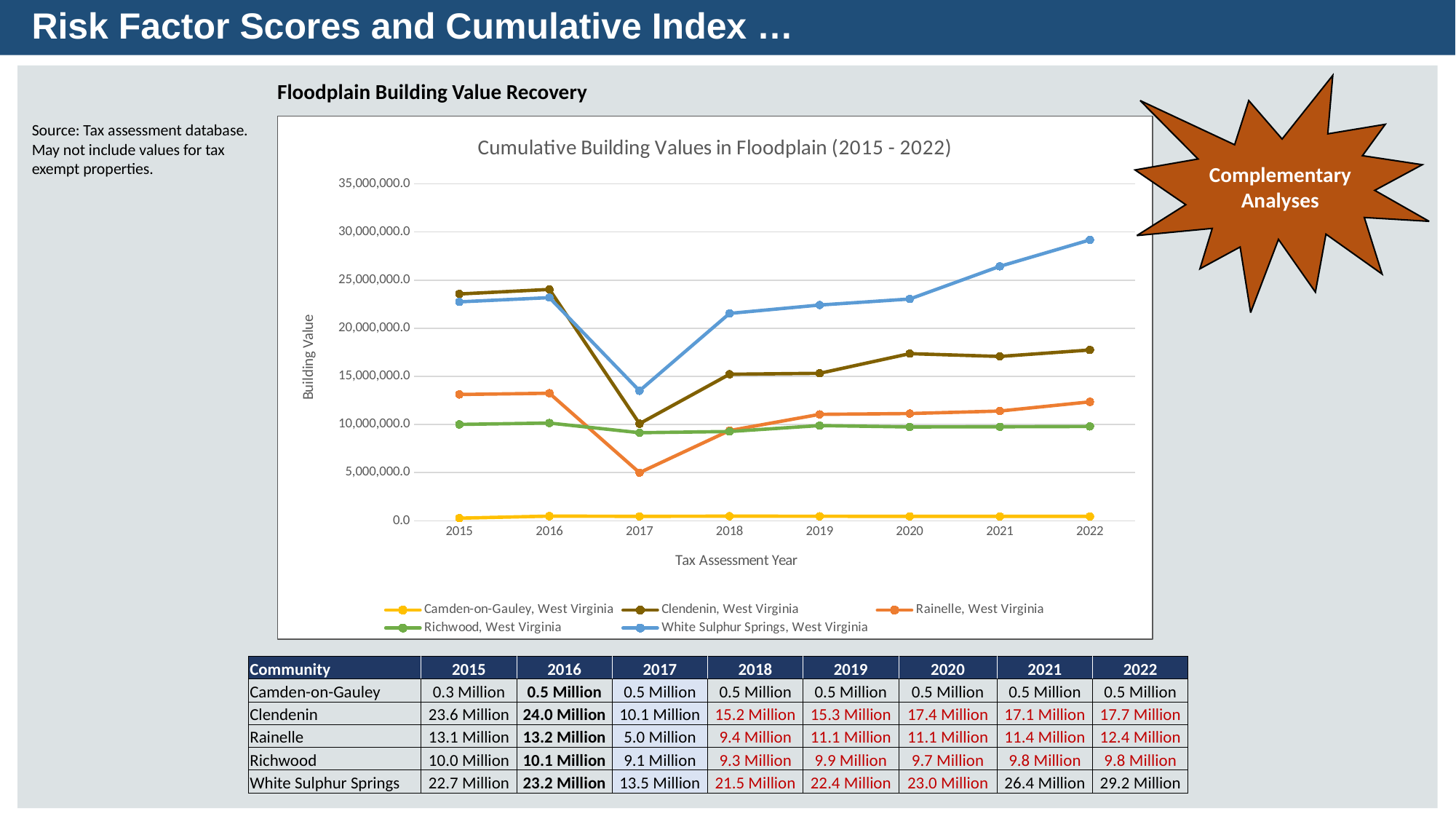
Which community has the highest building value in 2022? White Sulphur Springs What is the title of the chart? Cumulative Building Values in Floodplain (2015 - 2022) Which is larger in 2015, the building value for Clendenin or for White Sulphur Springs? Clendenin Which community has the lowest building value in 2015? Camden-on-Gauley Does the White Sulphur Springs line rise or fall from 2018 to 2022? rise What is the building value for White Sulphur Springs in 2022? 29.2 Million What type of chart is shown on the slide? line chart How many series does the chart legend list? 5 What is the building value for Clendenin in 2017? 10.1 Million How many tax assessment years are plotted on the x axis? 8 Is the value for White Sulphur Springs in 2021 greater or less than 25,000,000.0? greater What is the difference between the Rainelle building value in 2016 and in 2017? 8.2 Million